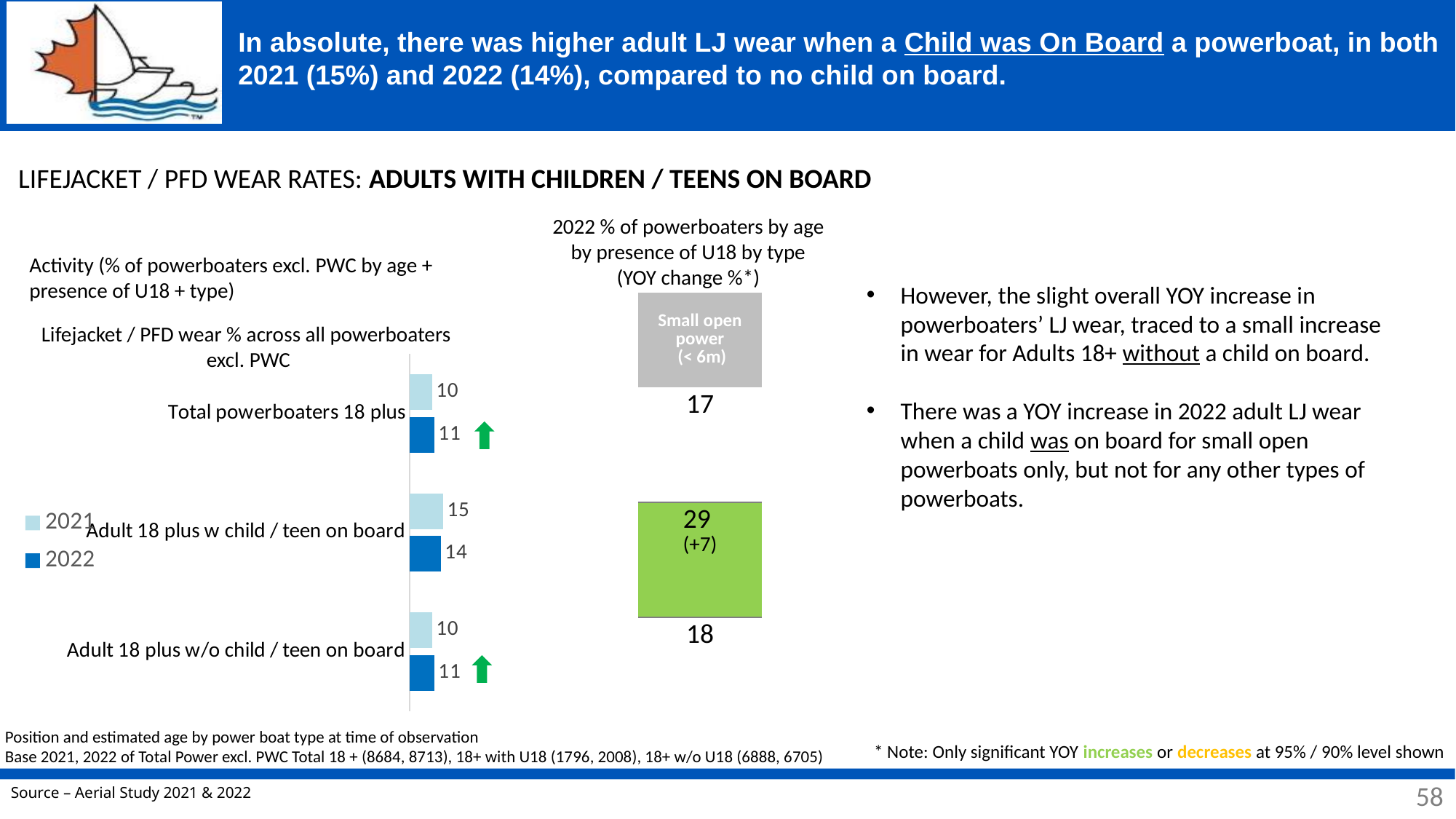
In the bar chart, what is the 2022 value for Adult 18 plus w child / teen on board? 14 In the bar chart, is the 2022 value for Adult 18 plus w child / teen on board larger or smaller than the 2022 value for Adult 18 plus w/o child / teen on board? Larger How many categories are shown in the bar chart? 3 In the bar chart, what is the 2022 value for Total powerboaters 18 plus? 11 What kind of chart is used to show the lifejacket / PFD wear % across all powerboaters excl. PWC? Bar chart In the bar chart, what is the 2021 value for Adult 18 plus w child / teen on board? 15 In the bar chart, what is the 2021 value for Adult 18 plus w/o child / teen on board? 10 How many series does the bar chart legend list? 2 In the bar chart, which category has the highest 2021 value? Adult 18 plus w child / teen on board In the bar chart, which category has the lowest 2022 value? Total powerboaters 18 plus and Adult 18 plus w/o child / teen on board (both 11) In the bar chart, which series is shown in light blue? 2021 In the bar chart, what is the difference between the 2021 and 2022 values for Adult 18 plus w child / teen on board? 1